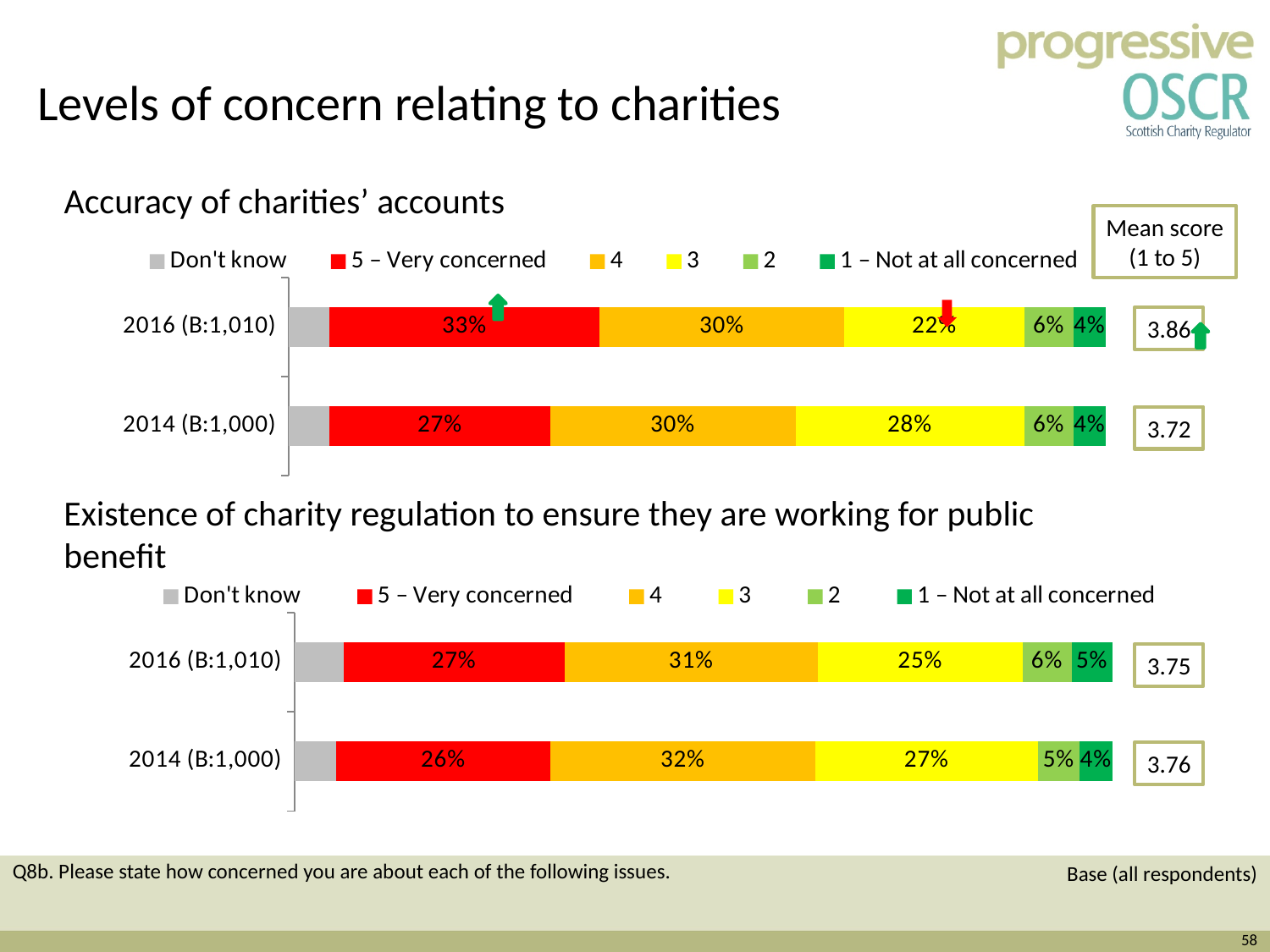
What is the mean score shown for 2016 in the 'Accuracy of charities' accounts' chart? 3.86 In the 'Accuracy of charities' accounts' chart, what percentage of 2014 respondents gave a rating of 3? 28% In the 'Accuracy of charities' accounts' chart, by how many percentage points did the '5 – Very concerned' share change from 2014 to 2016? 6 percentage points In the 'Existence of charity regulation' chart, what is the difference between the 2016 and 2014 shares rating 3? 2 percentage points How many year categories are shown in the 'Accuracy of charities' accounts' chart? 2 In the 'Existence of charity regulation' chart, what percentage of 2016 respondents gave a rating of 4? 31% In the 'Accuracy of charities' accounts' chart, which year had the larger share rating 3: 2016 or 2014? 2014 How many series does the legend of the 'Accuracy of charities' accounts' chart list? 6 In the 'Existence of charity regulation' chart, which rating category has the highest share for 2014? 4 What type of chart is used for 'Existence of charity regulation to ensure they are working for public benefit'? Stacked bar chart In the 'Existence of charity regulation' chart, what percentage of 2014 respondents were '1 – Not at all concerned'? 4% In the 'Accuracy of charities' accounts' chart, what percentage of 2016 respondents were '5 – Very concerned'? 33%